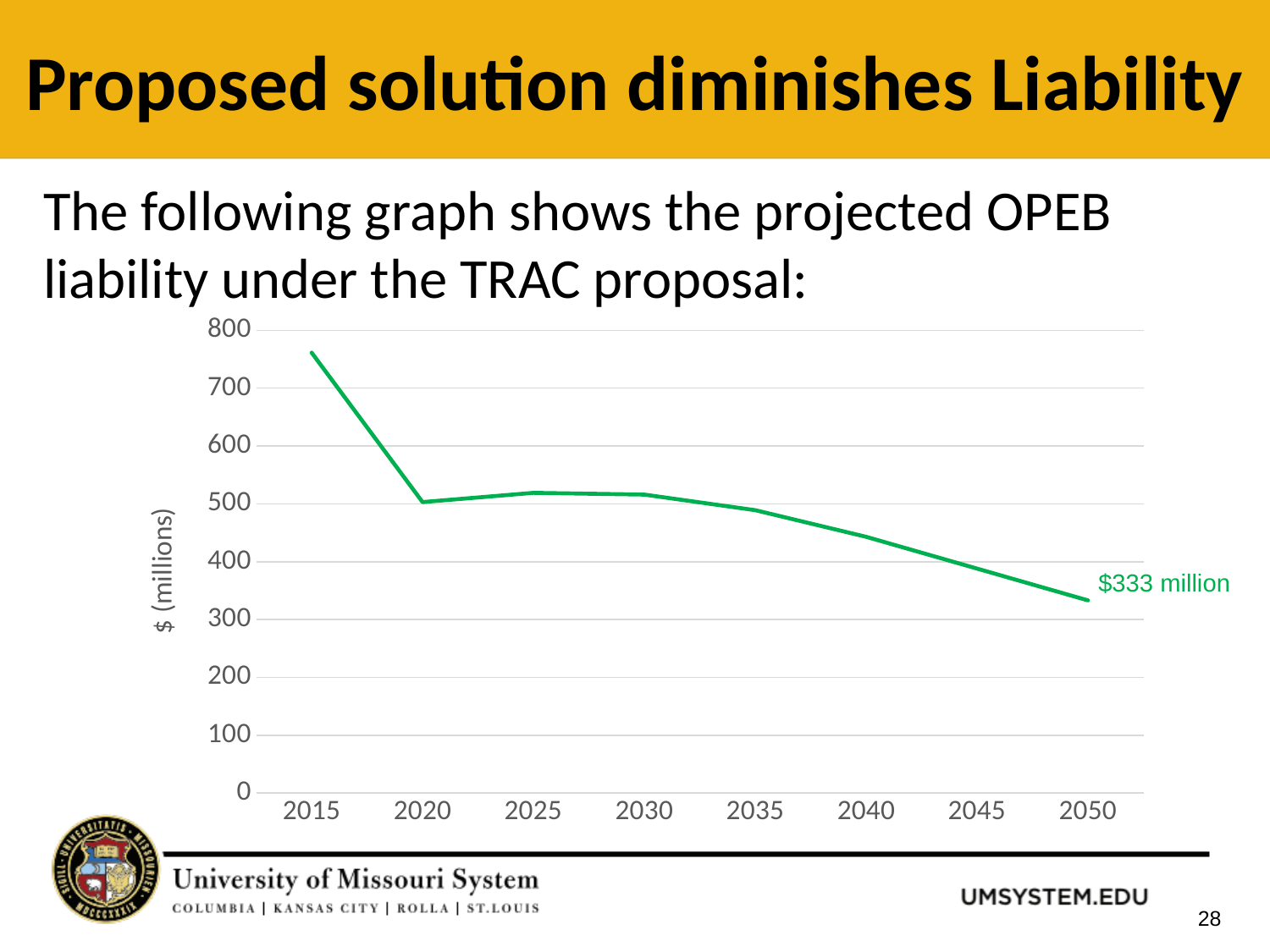
Is the value for 2015 greater or less than 700? greater In which year is the projected liability highest? 2015 What is the projected OPEB liability in 2050 according to the data label? $333 million What kind of chart is shown on the slide? line chart Which year has the larger projected liability, 2025 or 2045? 2025 In which year is the projected liability lowest? 2050 What is the label on the vertical axis of the chart? $ (millions) Overall, does the projected liability rise or fall from 2015 to 2050? fall Which year has the larger projected liability, 2015 or 2020? 2015 Is the value for 2020 greater or less than 600? less Is the value for 2040 greater or less than 400? greater How many years are marked along the x axis of the chart? 8